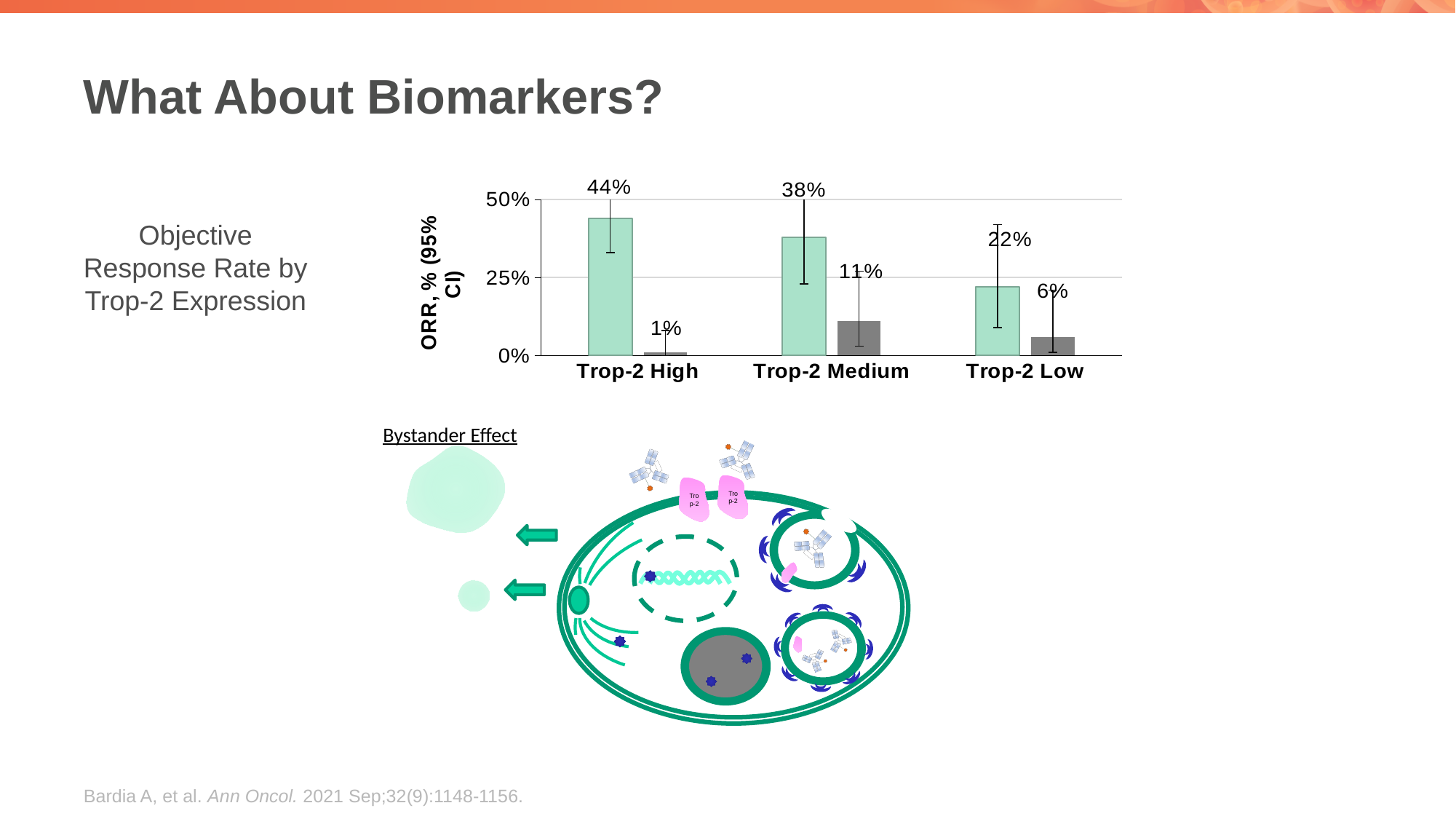
How many categories are shown on the x axis? 3 What is the label of the y axis of the chart? ORR, % (95% CI) What is the value of the grey bar for Trop-2 Medium? 11% What is the value of the green bar for Trop-2 Low? 22% Do the green bars rise or fall from Trop-2 High to Trop-2 Low? Fall Which is larger, the grey bar for Trop-2 Medium or the grey bar for Trop-2 Low? Trop-2 Medium Which category has the highest green bar? Trop-2 High What is the value of the green bar for Trop-2 High? 44% Which category has the lowest grey bar? Trop-2 High What type of chart is shown on the slide? Bar chart What is the value of the grey bar for Trop-2 High? 1% What is the difference between the green bar and the grey bar for Trop-2 Medium? 27%